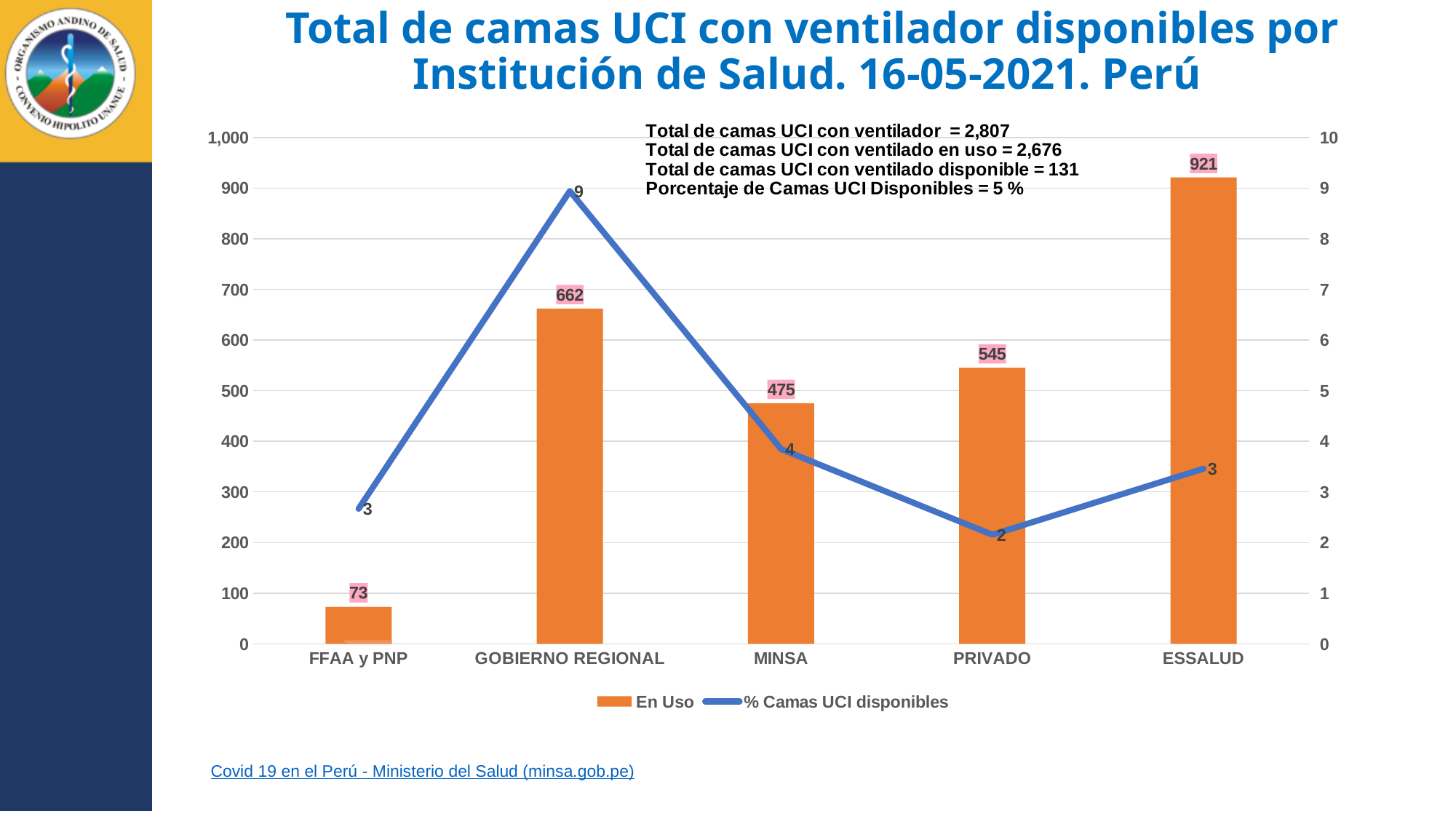
Which institution has the lowest '% Camas UCI disponibles' value? PRIVADO Which institution has the highest 'En Uso' value? ESSALUD How many series does the legend list? 2 What is the 'En Uso' value for FFAA y PNP? 73 What is the '% Camas UCI disponibles' value for PRIVADO? 2 What is the difference between the 'En Uso' values for GOBIERNO REGIONAL and MINSA? 187 According to the text on the chart, what is the total number of UCI beds with ventilator? 2,807 What kind of chart is used for the 'En Uso' series? Bar chart How many institutions are shown on the x axis? 5 Which has a larger 'En Uso' value, PRIVADO or MINSA? PRIVADO What is the '% Camas UCI disponibles' value for GOBIERNO REGIONAL? 9 What is the 'En Uso' value for ESSALUD? 921